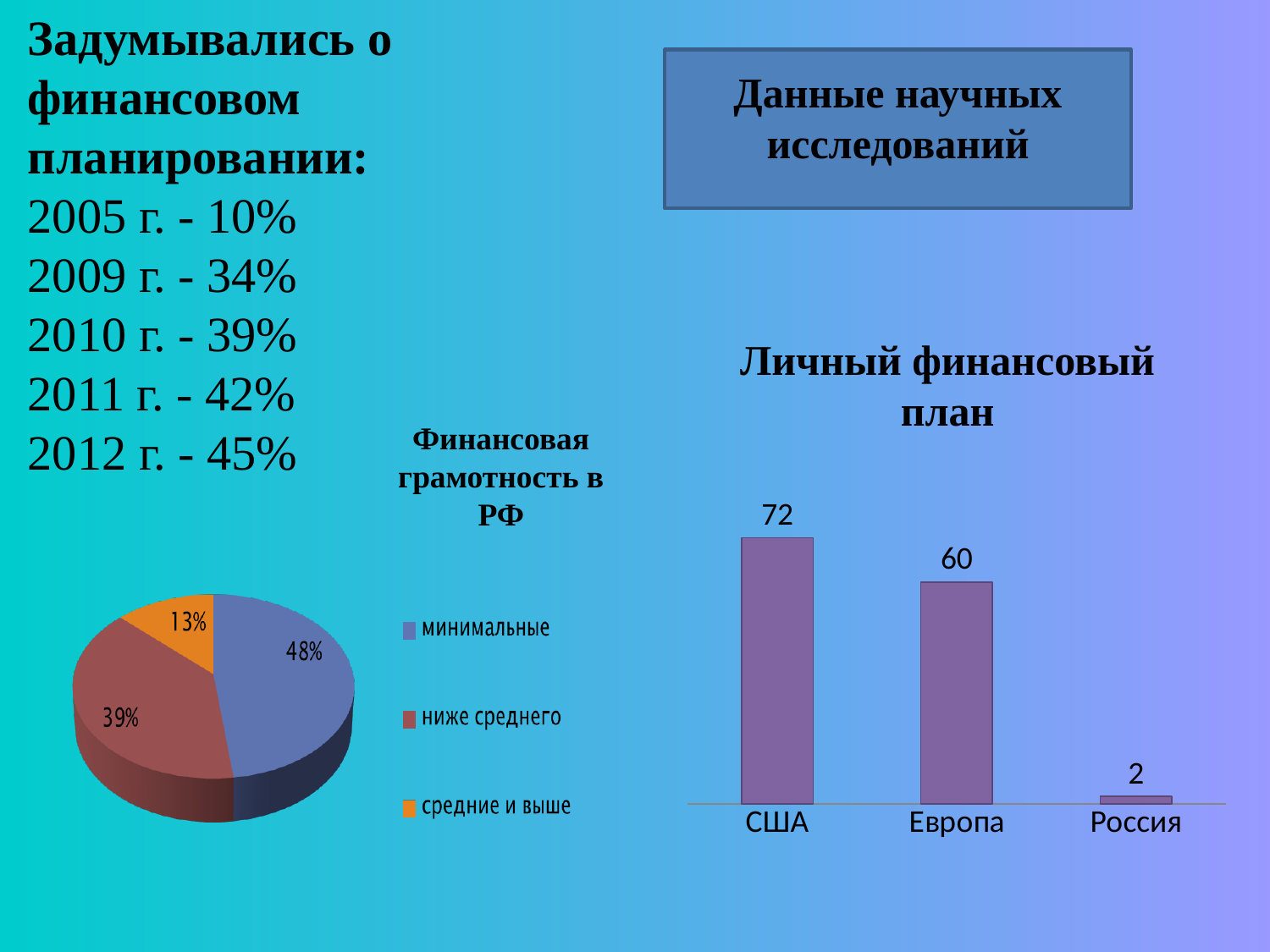
In the pie chart 'Финансовая грамотность в РФ', which slice is the largest? минимальные In the bar chart 'Личный финансовый план', what is the value for Европа? 60 In the bar chart 'Личный финансовый план', what is the value for США? 72 In the pie chart 'Финансовая грамотность в РФ', what share does 'средние и выше' have? 13% How many entries does the legend of the pie chart 'Финансовая грамотность в РФ' list? 3 In the bar chart 'Личный финансовый план', what is the value for Россия? 2 In the bar chart 'Личный финансовый план', which category has the highest value? США In the bar chart 'Личный финансовый план', what is the difference between the values for США and Европа? 12 In the bar chart 'Личный финансовый план', which category has the lowest value? Россия In the bar chart 'Личный финансовый план', how many categories are shown? 3 In the pie chart 'Финансовая грамотность в РФ', what share does 'минимальные' have? 48% What kind of chart is 'Личный финансовый план'? bar chart